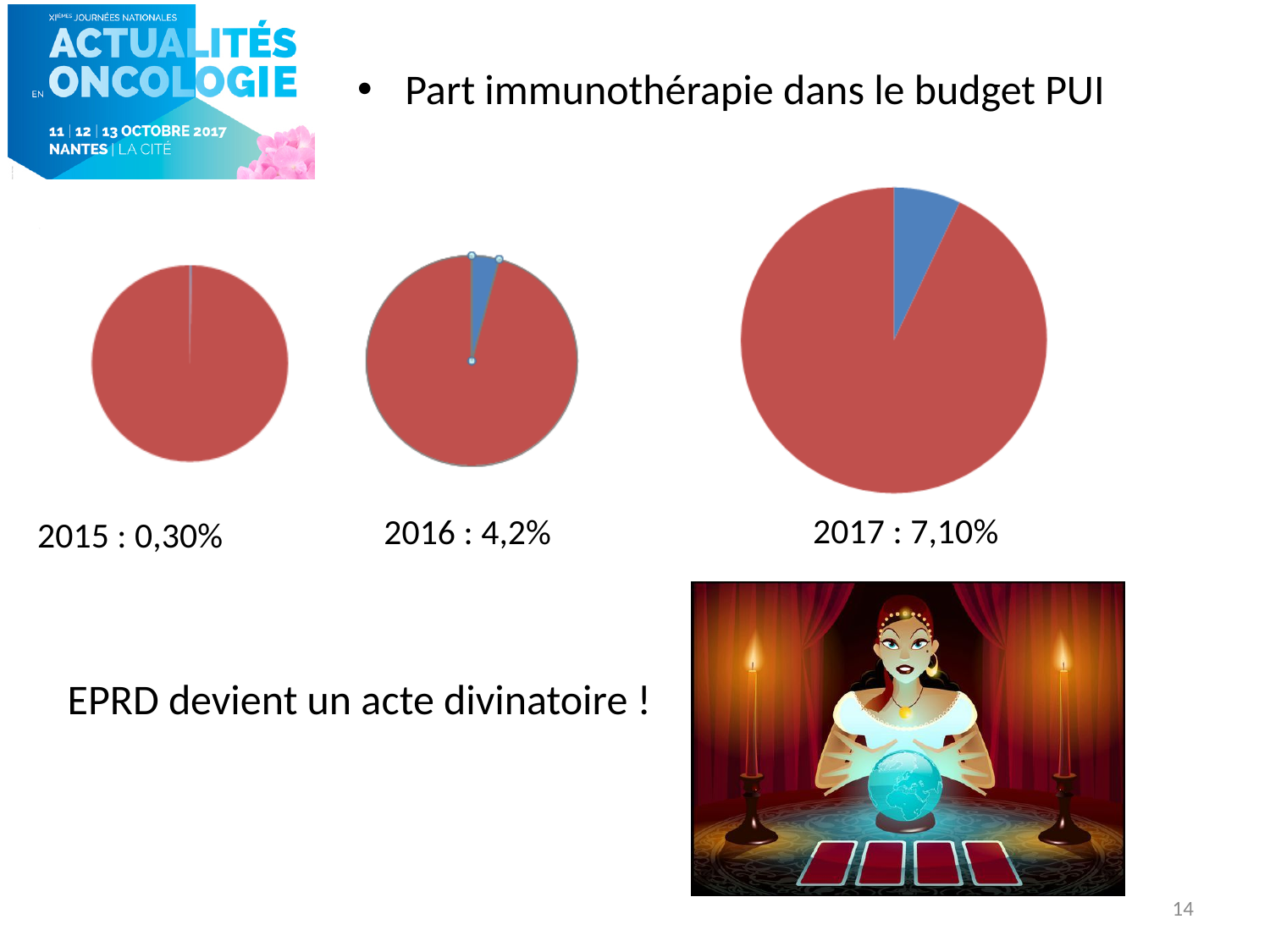
What colour is the slice representing immunotherapy in the pie charts? Blue What is the immunotherapy share of the PUI budget shown for 2017? 7,10% By how many percentage points did the immunotherapy share increase from 2016 to 2017? 2,9% Which year has the highest immunotherapy share of the PUI budget? 2017 What is the immunotherapy share of the PUI budget shown for 2015? 0,30% Is the immunotherapy share larger in 2016 or in 2015? 2016 How many pie charts are shown on the slide? 3 Does the immunotherapy share of the PUI budget rise or fall from 2015 to 2017? Rise What type of chart is used to show the immunotherapy share of the PUI budget? Pie chart What is the immunotherapy share of the PUI budget shown for 2016? 4,2% Which year has the lowest immunotherapy share of the PUI budget? 2015 By how many percentage points did the immunotherapy share increase from 2015 to 2017? 6,8%